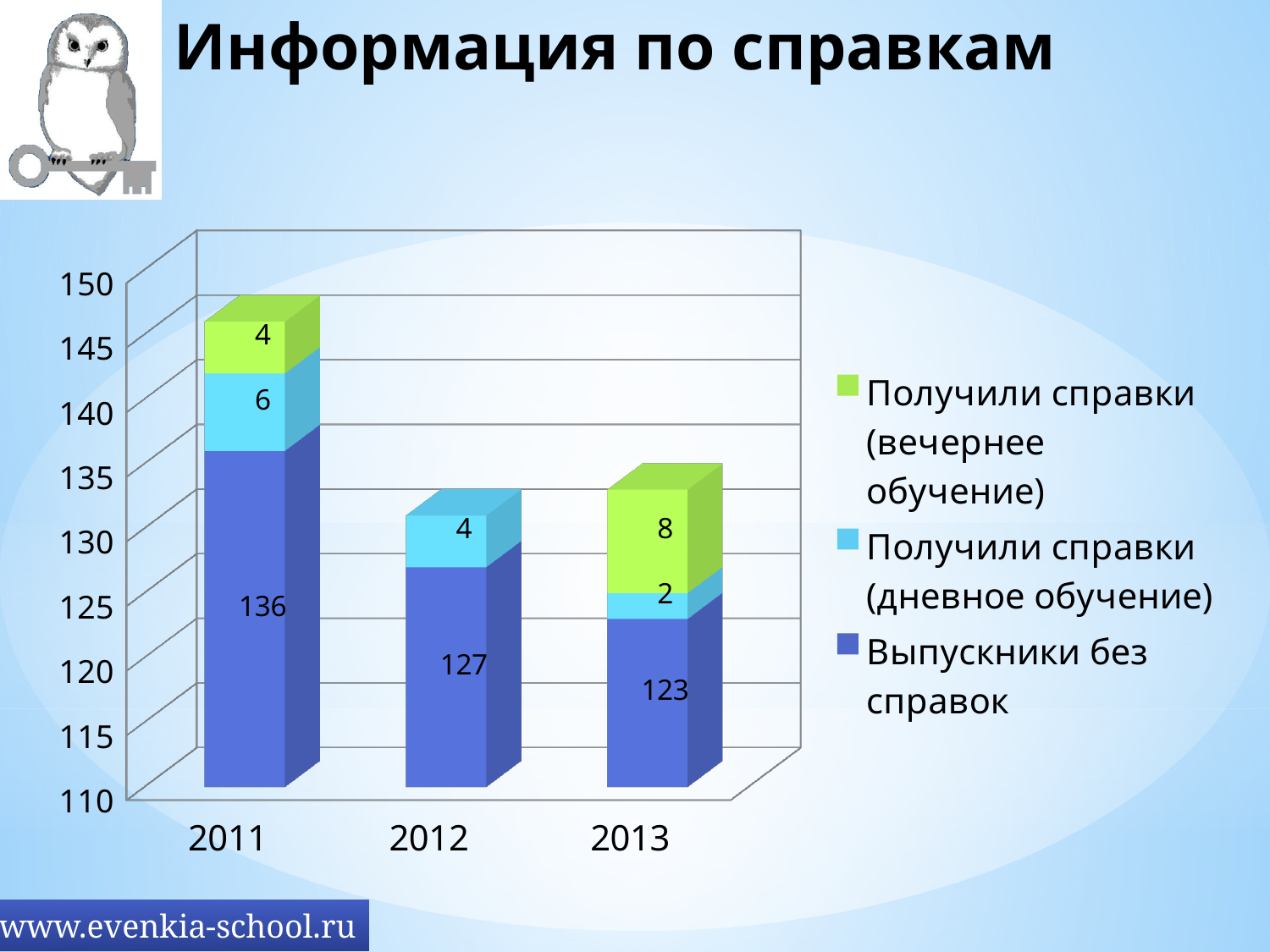
What is the value for "Выпускники без справок" in 2011? 136 In which year is the value for "Выпускники без справок" the lowest? 2013 How many series does the legend list? 3 What is the difference between the "Выпускники без справок" values for 2011 and 2013? 13 What kind of chart is shown on the slide? Stacked bar chart What is the value for "Получили справки (дневное обучение)" in 2012? 4 What is the total of the stacked bar for 2011? 146 Which is larger: the "Получили справки (дневное обучение)" value for 2011 or for 2013? 2011 How many years are shown on the x axis? 3 In which year is the value for "Выпускники без справок" the highest? 2011 Does the value for "Выпускники без справок" rise or fall from 2011 to 2013? Fall What is the value for "Получили справки (вечернее обучение)" in 2013? 8